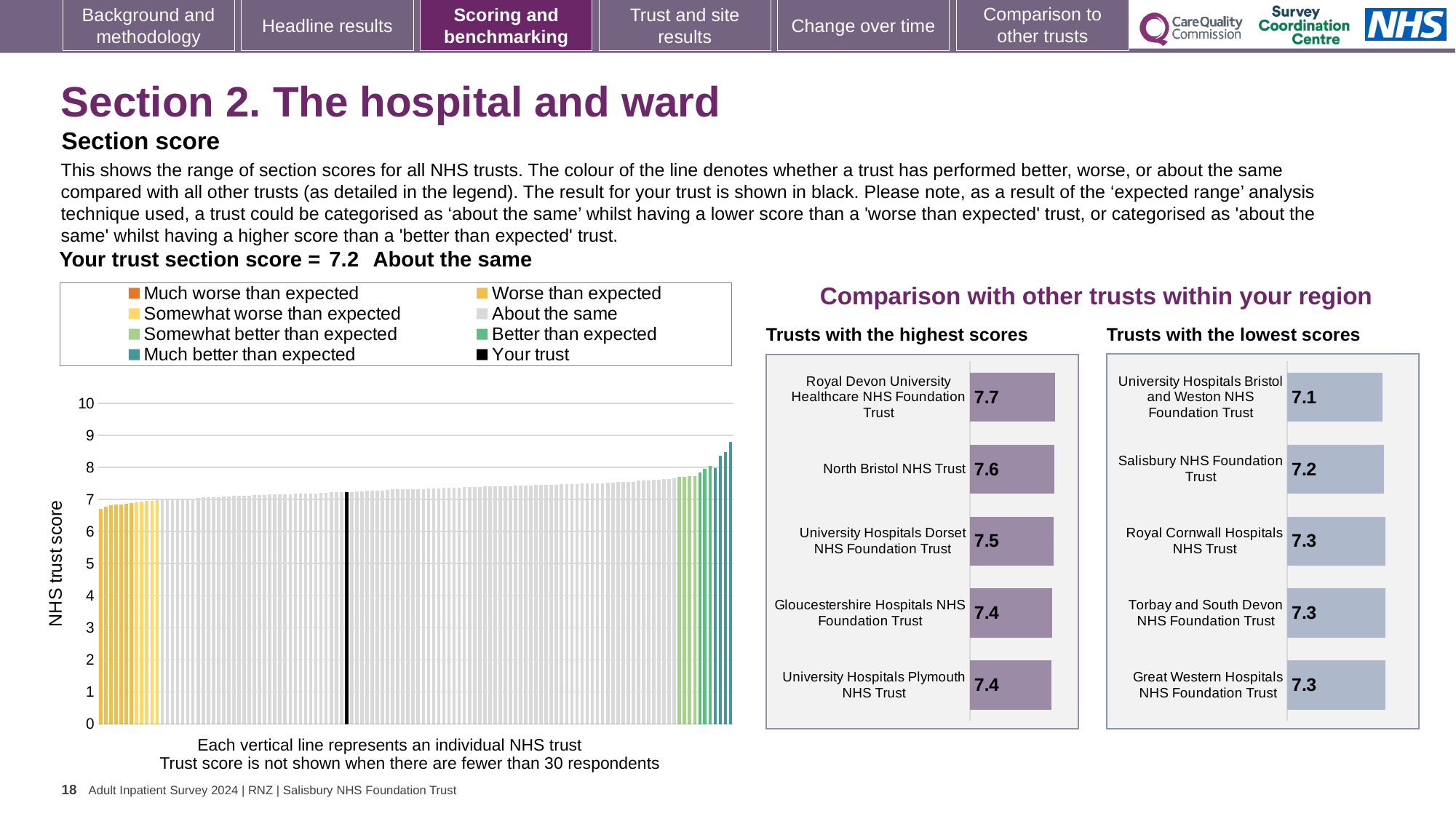
In the 'Trusts with the lowest scores' chart, what is the score for Salisbury NHS Foundation Trust? 7.2 How many entries does the legend of the NHS trust score chart on the left list? 8 In the 'Trusts with the lowest scores' chart, which trust has the lowest score? University Hospitals Bristol and Weston NHS Foundation Trust In the NHS trust score chart on the left, is the value of the black 'Your trust' bar greater or less than 8? less In the 'Trusts with the highest scores' chart, which has the higher score: North Bristol NHS Trust or University Hospitals Dorset NHS Foundation Trust? North Bristol NHS Trust In the 'Trusts with the highest scores' chart, what is the score for Royal Devon University Healthcare NHS Foundation Trust? 7.7 In the 'Trusts with the lowest scores' chart, what is the difference between the scores of Great Western Hospitals NHS Foundation Trust and University Hospitals Bristol and Weston NHS Foundation Trust? 0.2 How many trusts are listed in the 'Trusts with the lowest scores' chart? 5 In the NHS trust score chart on the left, is the value of the tallest bar greater or less than 8? greater What kind of chart is the 'Trusts with the highest scores' chart? Bar chart In the 'Trusts with the highest scores' chart, which trust has the lowest score shown? Gloucestershire Hospitals NHS Foundation Trust and University Hospitals Plymouth NHS Trust (7.4) In the 'Trusts with the highest scores' chart, what is the difference between the scores of Royal Devon University Healthcare NHS Foundation Trust and University Hospitals Plymouth NHS Trust? 0.3